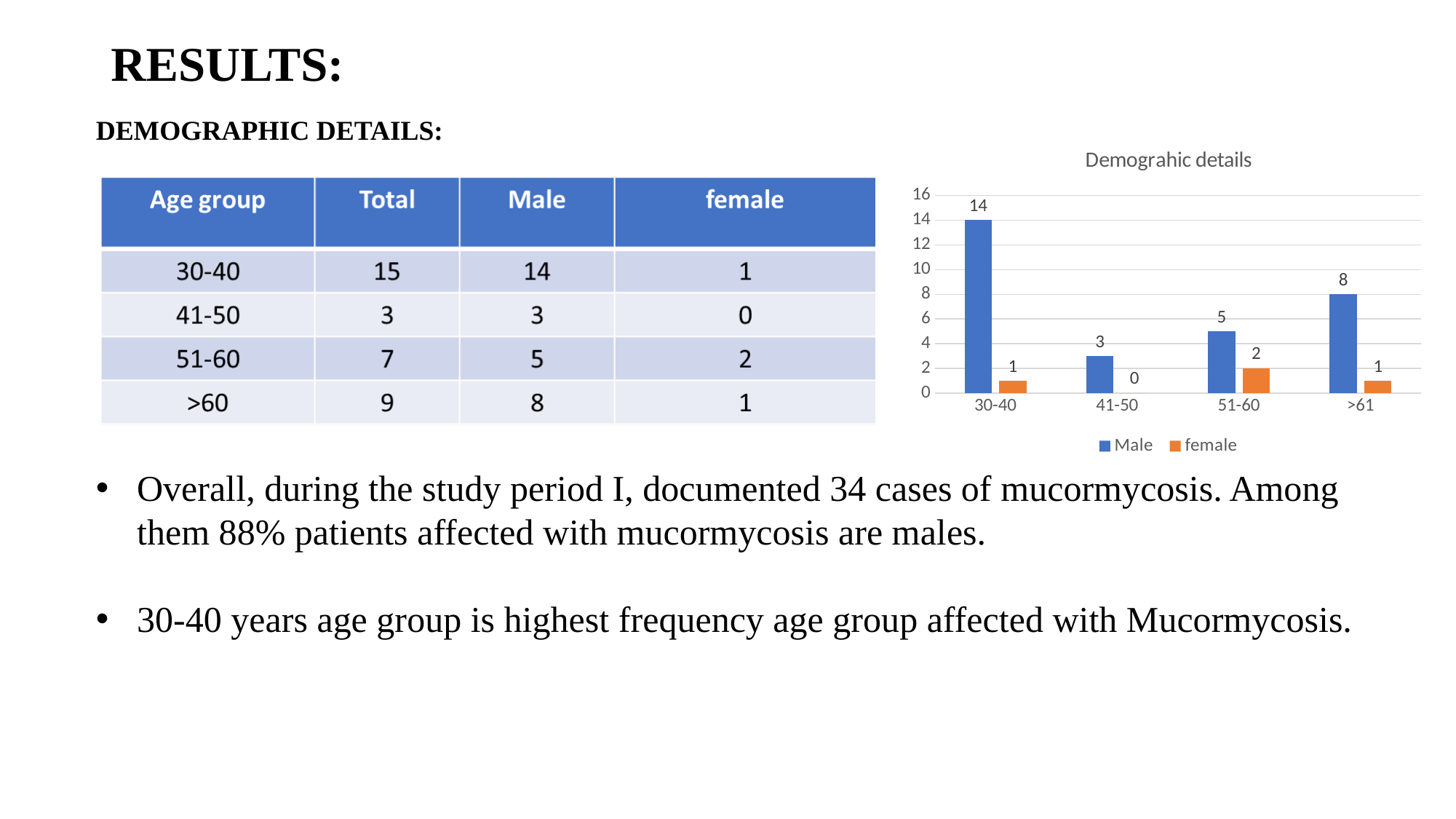
How many series does the chart legend list? 2 What is the female value for the 41-50 age group in the chart? 0 Which age group has the highest Male value in the chart? 30-40 What is the difference between the Male and female values for the 30-40 age group? 13 How many age groups are shown on the x axis of the chart? 4 Which age group has the lowest Male value in the chart? 41-50 What is the Male value for the 30-40 age group in the chart? 14 What kind of chart is shown on the slide? Bar chart What is the title of the chart? Demograhic details What is the Male value for the >61 age group in the chart? 8 Which is larger in the chart: the Male value for 51-60 or the Male value for >61? Male value for >61 What is the female value for the 51-60 age group in the chart? 2